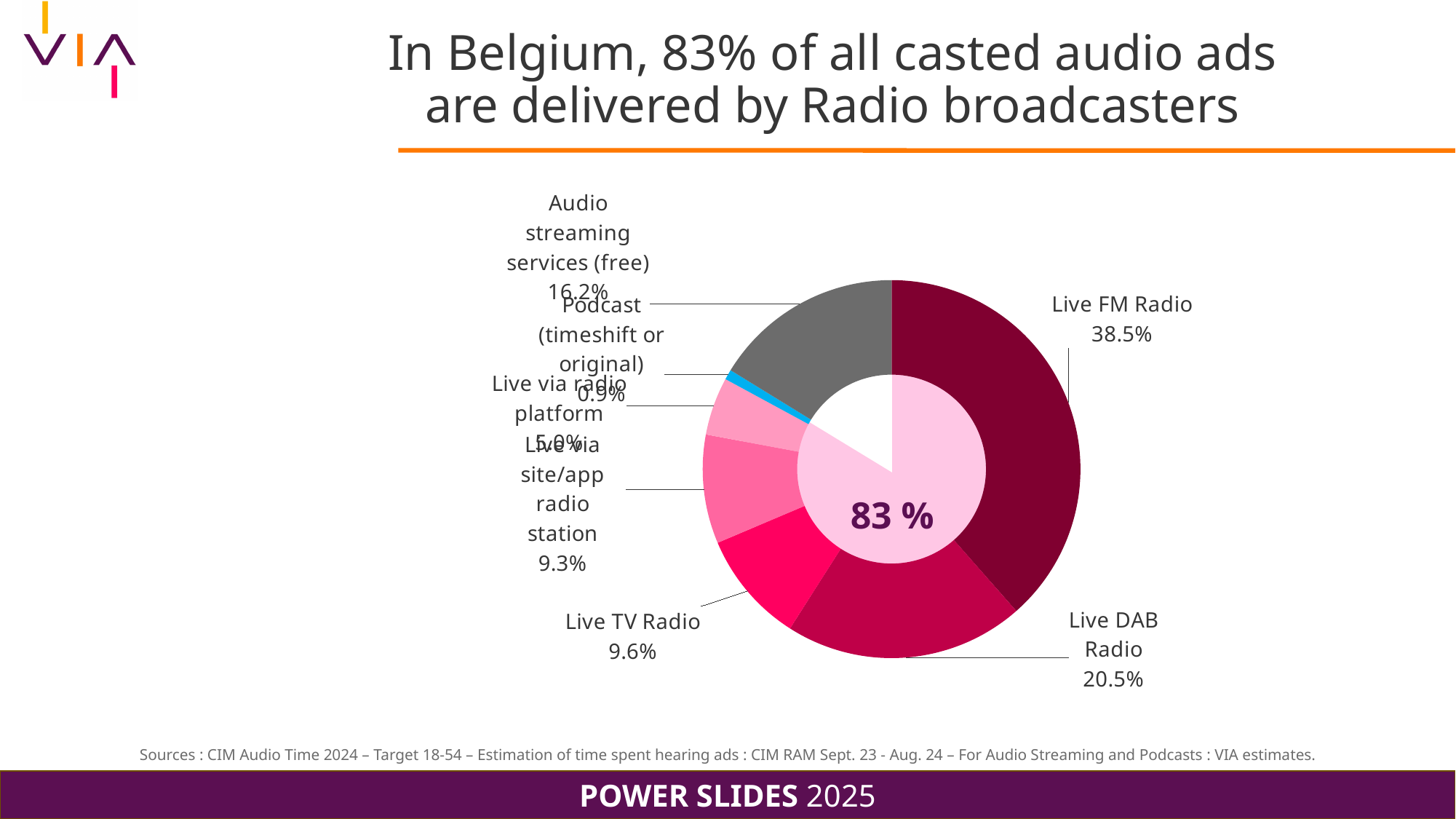
Which category has the smallest share of the chart? Podcast (timeshift or original) What kind of chart is shown on the slide? Donut (pie) chart What share is shown for Audio streaming services (free)? 16.2% What share is shown for Live TV Radio? 9.6% What percentage is printed in the centre of the donut chart? 83 % How many categories (slices) does the chart show? 7 What share is shown for Live DAB Radio? 20.5% What share is shown for Live via site/app radio station? 9.3% Which is larger, the share for Live DAB Radio or the share for Audio streaming services (free)? Live DAB Radio What is the difference between the shares of Live FM Radio and Live DAB Radio? 18 percentage points What share of casted audio ads is delivered by Live FM Radio? 38.5% Which category has the largest share of the chart? Live FM Radio